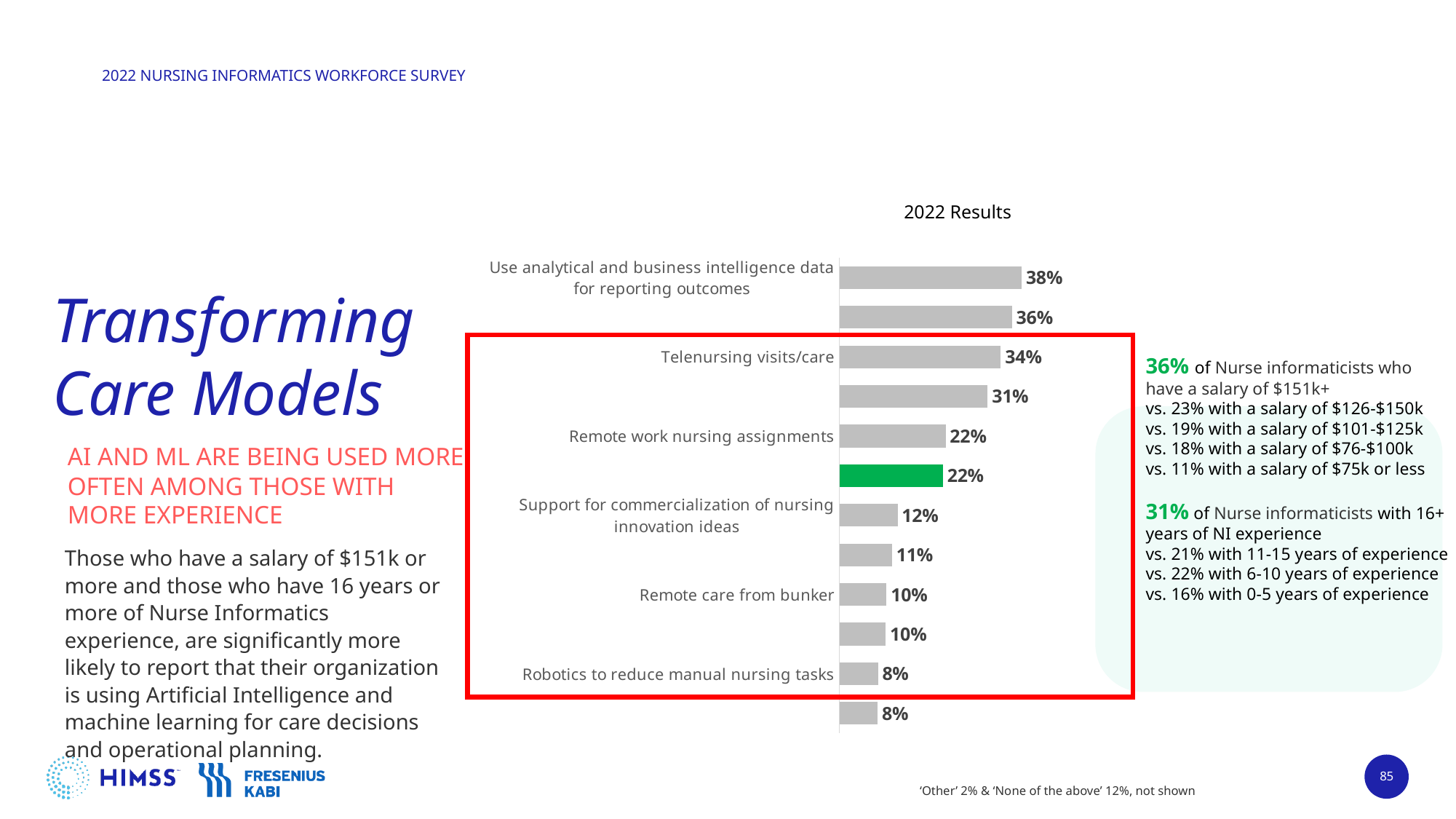
Which labeled category has the highest value? Use analytical and business intelligence data for reporting outcomes What is the title of the chart? 2022 Results What is the value for 'Support for commercialization of nursing innovation ideas'? 12% What kind of chart is shown on the slide? bar chart What is the value for 'Remote work nursing assignments'? 22% What is the difference between 'Telenursing visits/care' and 'Remote work nursing assignments'? 12% What is the value for 'Telenursing visits/care'? 34% What is the value for 'Robotics to reduce manual nursing tasks'? 8% What is the lowest value shown on the chart? 8% What is the value for 'Use analytical and business intelligence data for reporting outcomes'? 38% What is the value for 'Remote care from bunker'? 10% How many bars are plotted on the chart? 12